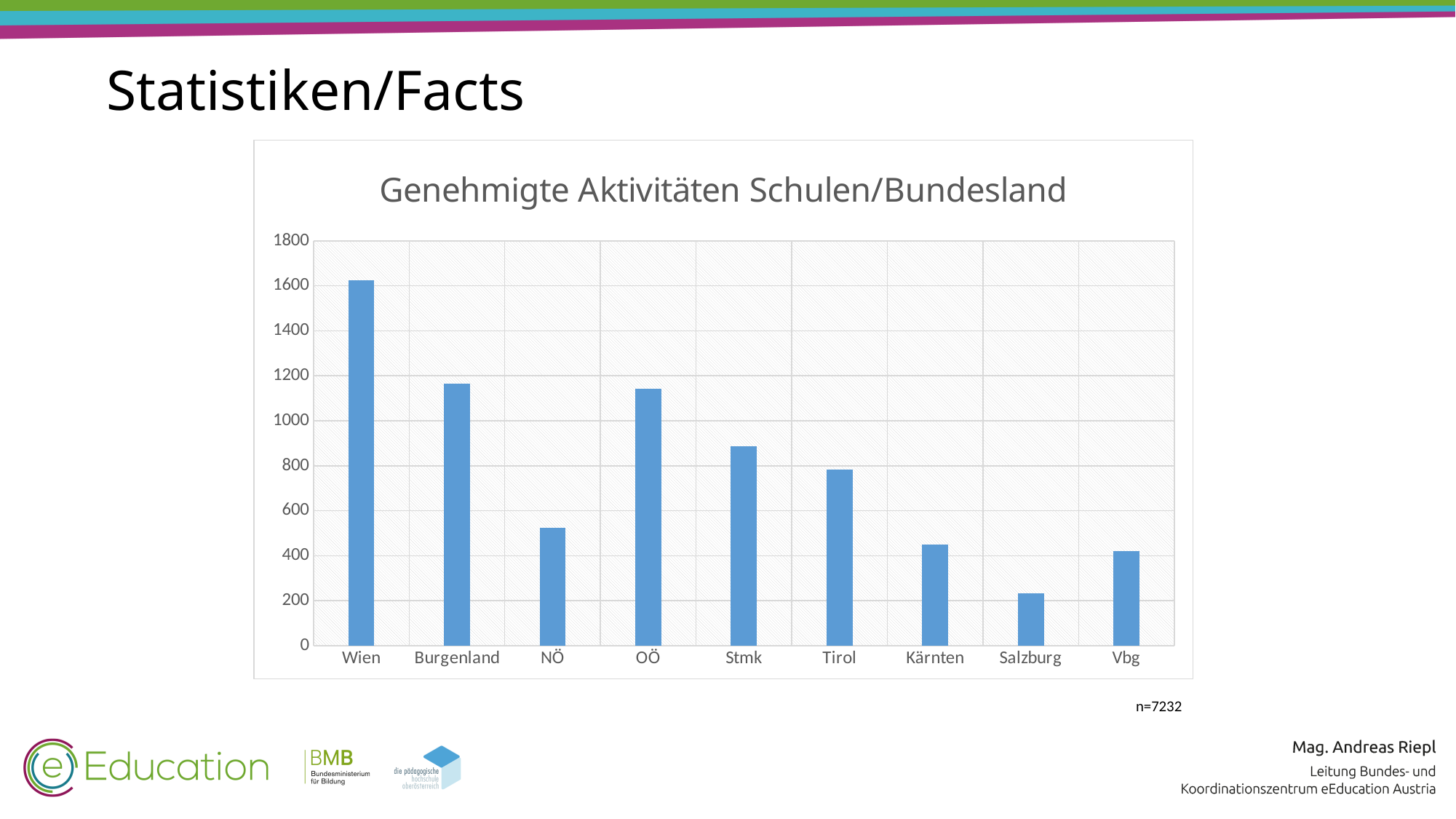
How many Bundesländer (categories) are shown on the x axis? 9 Is the value for Stmk greater or less than 800? greater Is the value for Wien greater or less than 1600? greater Which Bundesland has the lowest value? Salzburg What sample size (n) is noted below the chart? n=7232 Is the value for Salzburg greater or less than 400? less What is the title of the chart? Genehmigte Aktivitäten Schulen/Bundesland Which Bundesland has the highest value? Wien Which has a larger value, Stmk or Tirol? Stmk What type of chart is shown on the slide? bar chart Which has a larger value, Wien or Burgenland? Wien